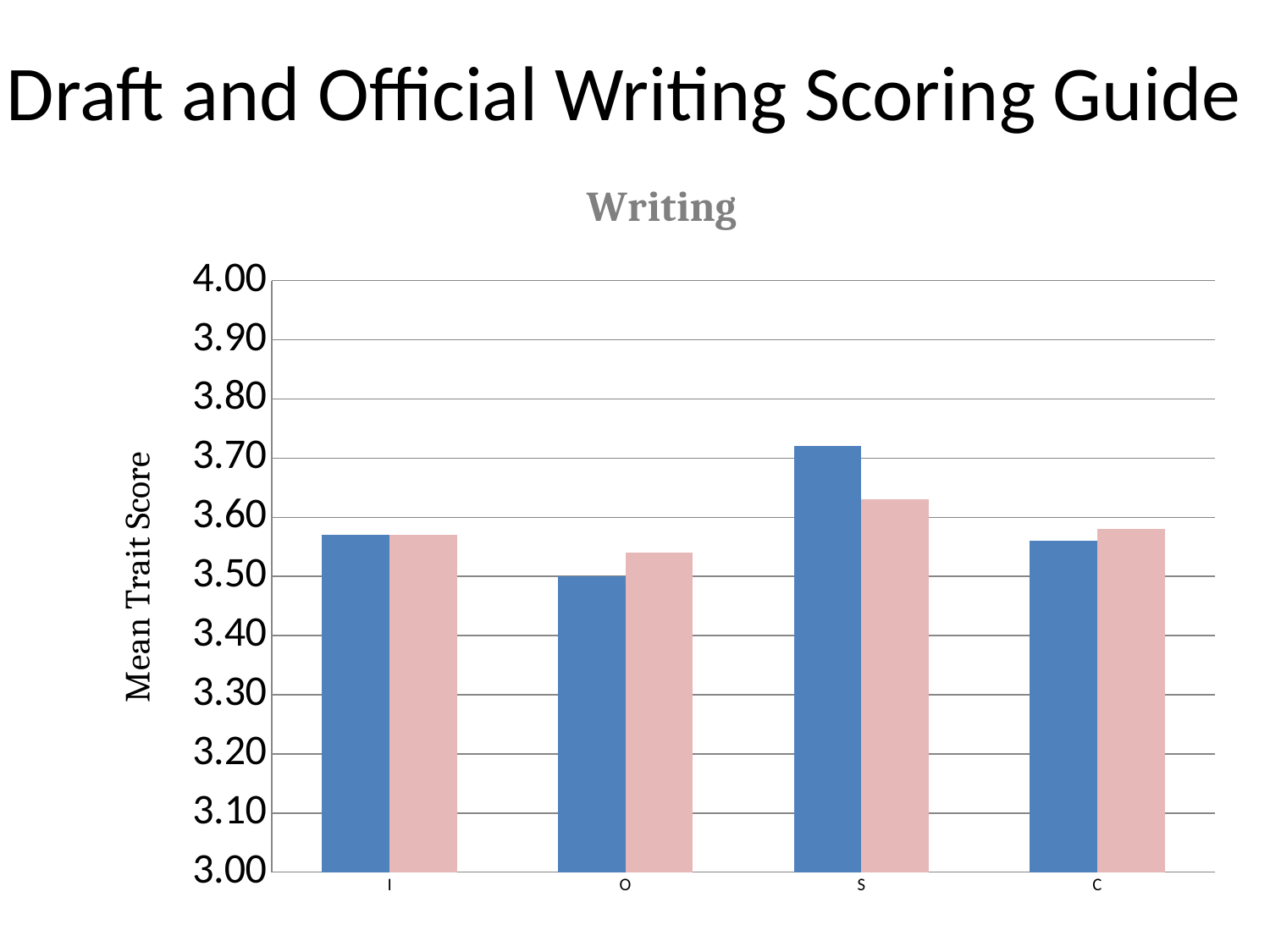
Which category has the tallest pink bar? S How many bars are shown for each category on the chart? 2 For category O, is the blue bar or the pink bar taller? pink What is the label on the vertical axis of the chart? Mean Trait Score What is the title of the chart? Writing Is the value of the pink bar for O greater or less than 3.60? less Which category has the tallest blue bar? S How many categories are shown along the x axis of the chart? 4 Is the value of the blue bar for S greater or less than 3.60? greater For category S, is the blue bar or the pink bar taller? blue Which category has the shortest blue bar? O What kind of chart is shown on the slide? bar chart